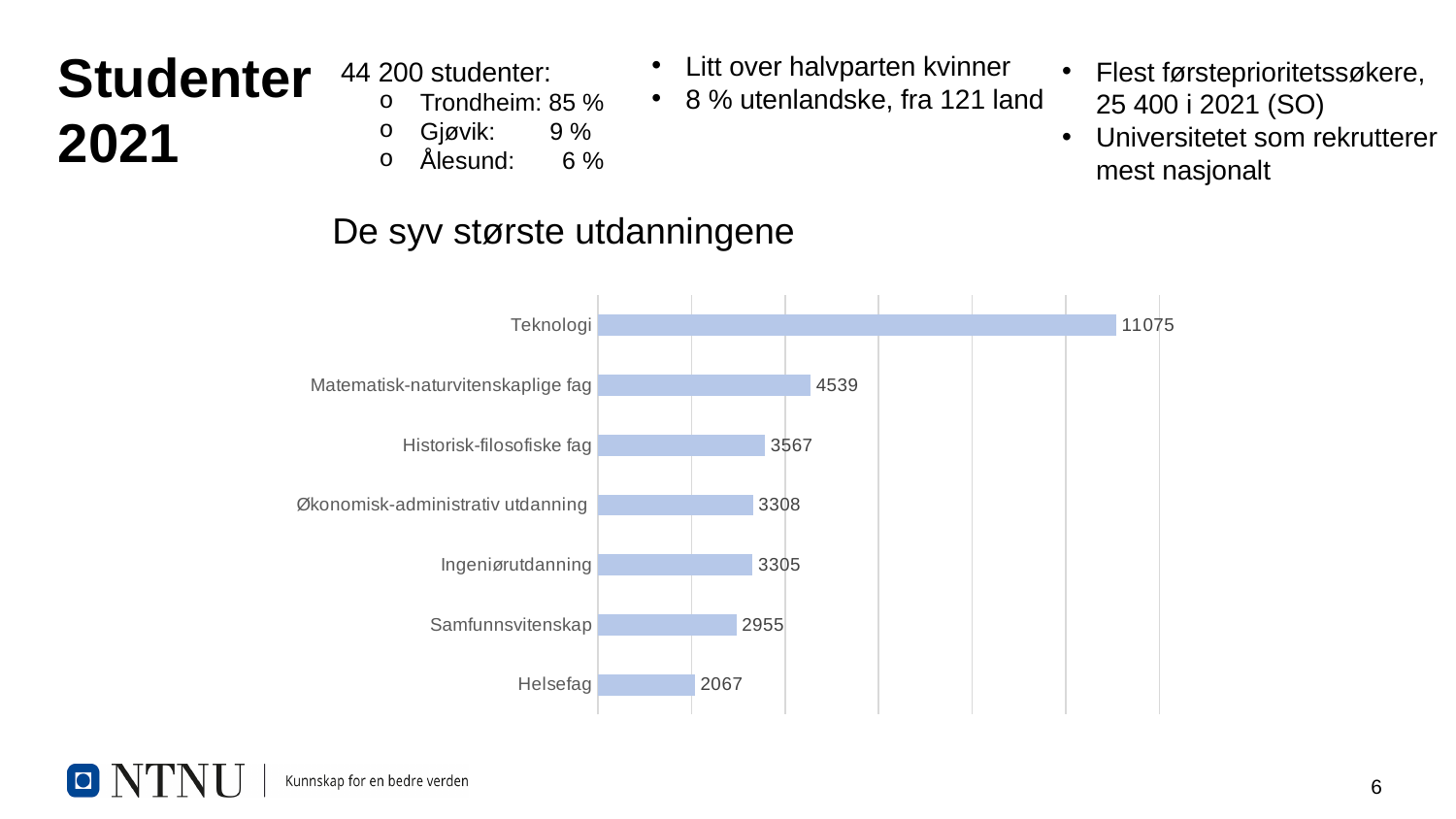
Which category has the highest value? Teknologi How many categories are shown in the chart? 7 What is the value for Historisk-filosofiske fag? 3567 What kind of chart is shown? Bar chart Which category has the lowest value? Helsefag What is the value for Helsefag? 2067 What is the title of the chart? De syv største utdanningene What is the value for Teknologi? 11075 Which is larger, Historisk-filosofiske fag or Ingeniørutdanning? Historisk-filosofiske fag What is the difference between Samfunnsvitenskap and Helsefag? 888 What is the difference between Teknologi and Matematisk-naturvitenskaplige fag? 6536 What is the value for Samfunnsvitenskap? 2955